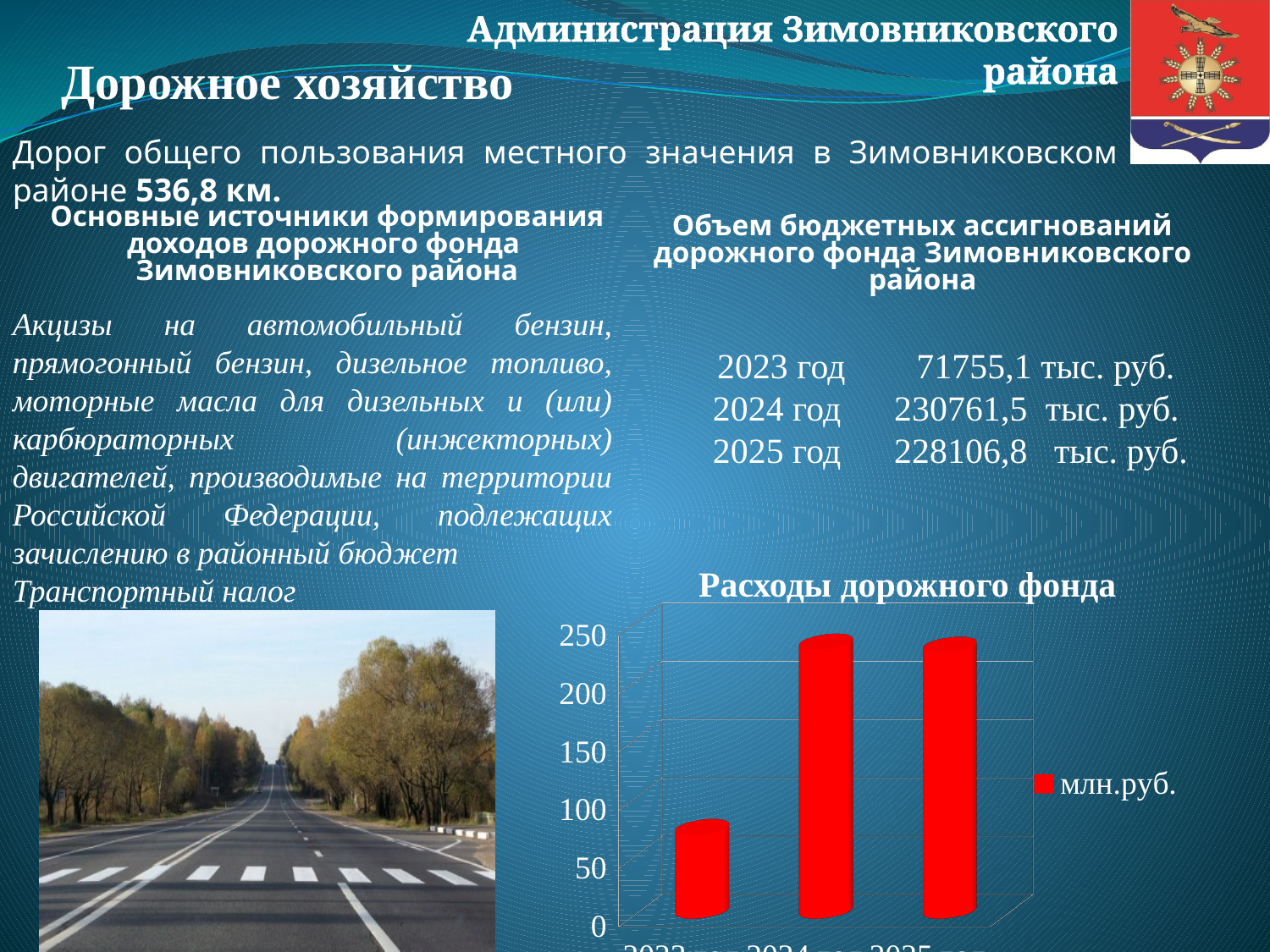
In the "Расходы дорожного фонда" chart, is the value for 2023 год greater or less than 100? less How many series does the legend of the "Расходы дорожного фонда" chart list? 1 In the "Расходы дорожного фонда" chart, is the value for 2023 год greater or less than 50? greater How many bars are plotted in the "Расходы дорожного фонда" chart? 3 What is the legend entry of the "Расходы дорожного фонда" chart? млн.руб. In the "Расходы дорожного фонда" chart, which is larger, the value for 2023 год or the value for 2024 год? 2024 год In the "Расходы дорожного фонда" chart, is the value for 2024 год greater or less than 200? greater Which year has the lowest value in the "Расходы дорожного фонда" chart? 2023 год In the "Расходы дорожного фонда" chart, does the value rise or fall from 2023 год to 2024 год? rise What colour are the bars in the "Расходы дорожного фонда" chart? red What kind of chart is "Расходы дорожного фонда"? bar chart